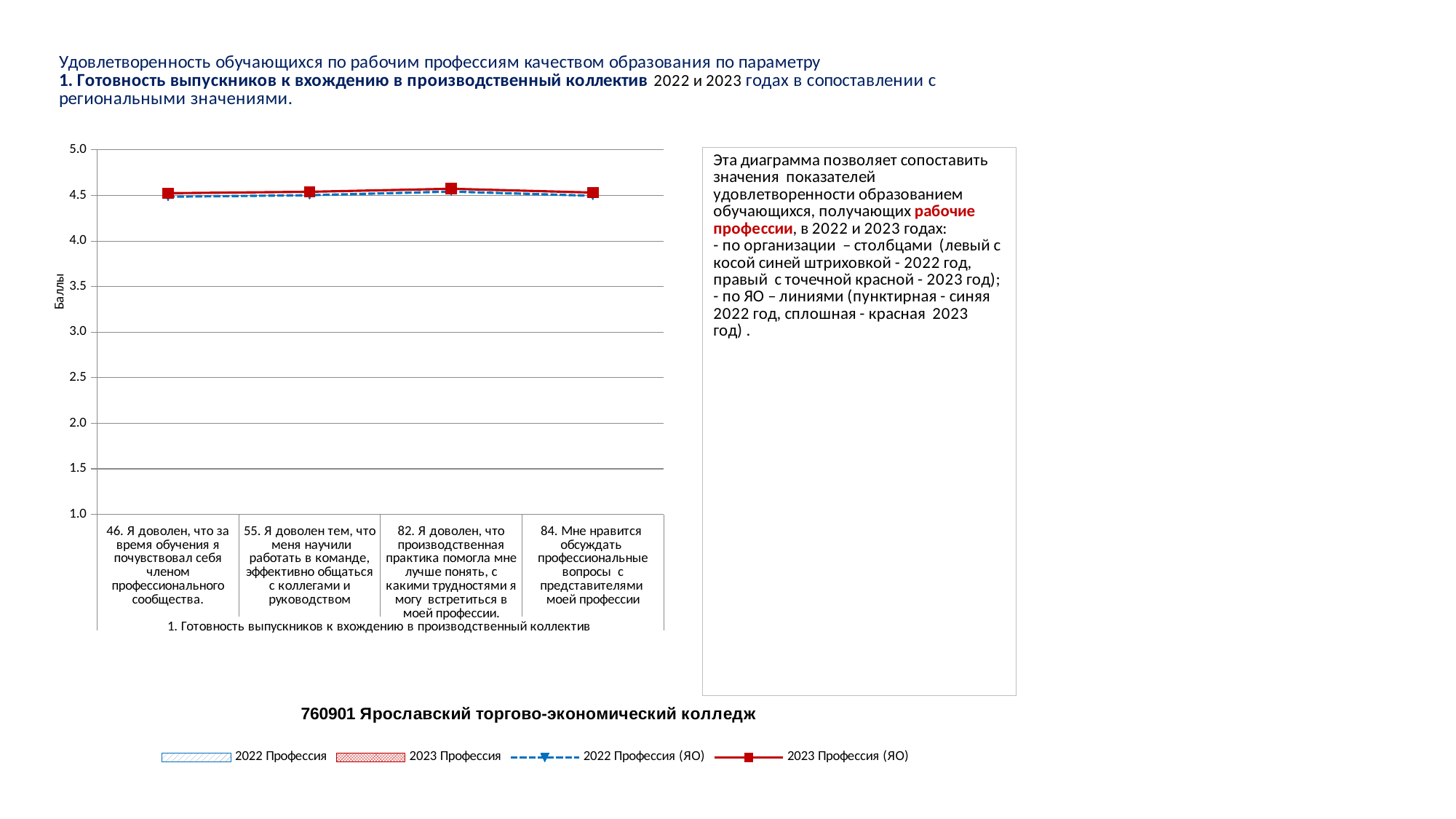
Is the value of the 2023 Профессия (ЯО) line for category 82 greater or less than 4.0? greater How many categories are shown on the x axis of the chart? 4 What is the label of the vertical axis of the chart? Баллы What is the lowest value shown on the vertical axis of the chart? 1.0 How many series does the chart legend list? 4 What is the name of the last series listed in the chart legend? 2023 Профессия (ЯО) Is the value of the 2022 Профессия (ЯО) line for category 46 greater or less than 3.5? greater What kind of chart is shown on the slide? line chart Is the value of the 2023 Профессия (ЯО) line for category 84 greater or less than 3.0? greater For which category does the 2023 Профессия (ЯО) line reach its highest point? 82. Я доволен, что производственная практика помогла мне лучше понять, с какими трудностями я могу встретиться в моей профессии.